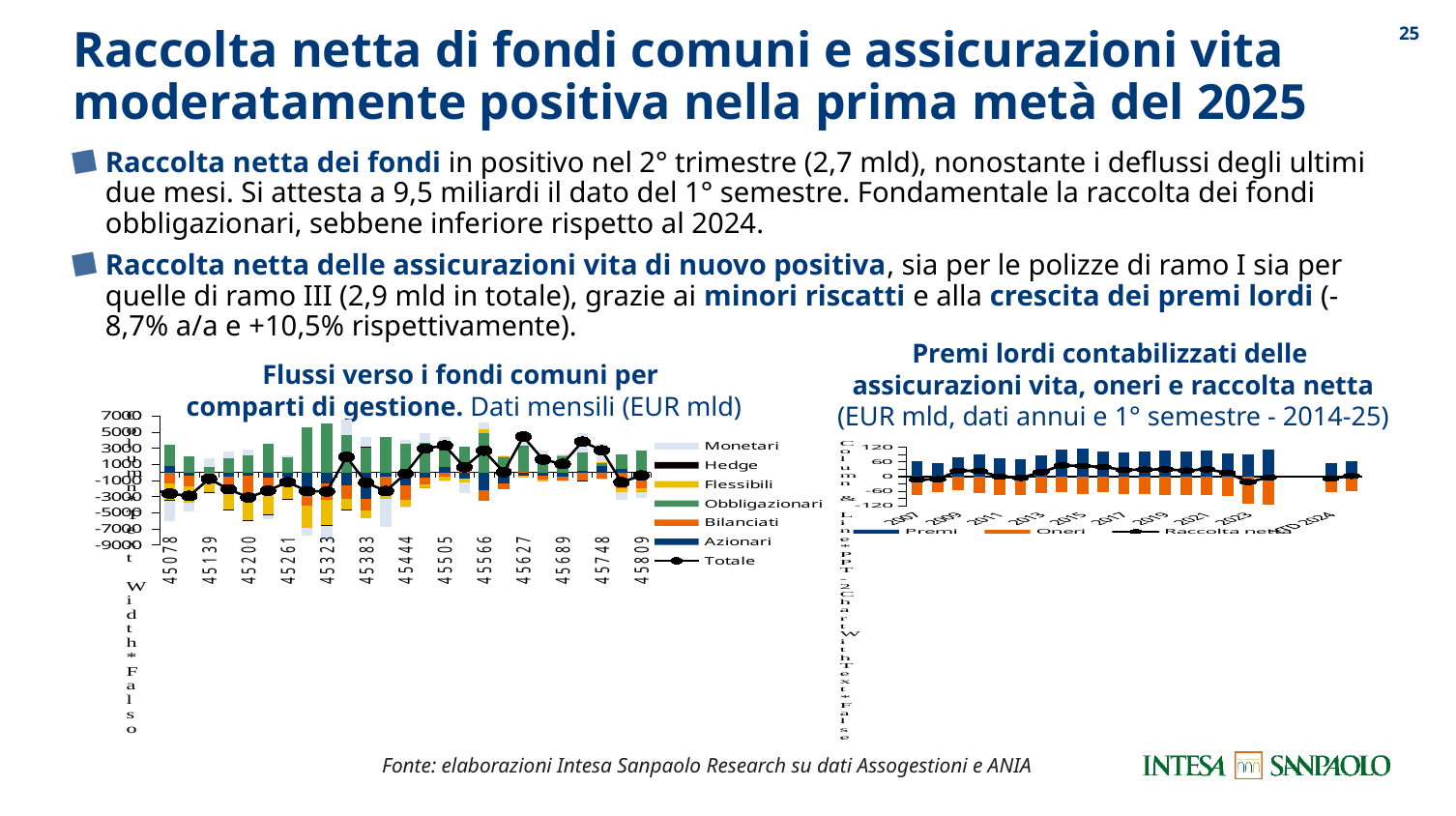
In the right chart 'Premi lordi contabilizzati delle assicurazioni vita, oneri e raccolta netta', are the Premi bars plotted above or below zero? Above zero How many series does the legend of the right chart 'Premi lordi contabilizzati delle assicurazioni vita, oneri e raccolta netta' list? 3 What unit is stated for the data in the right chart 'Premi lordi contabilizzati delle assicurazioni vita, oneri e raccolta netta'? EUR mld What is the first year label on the x axis of the right chart 'Premi lordi contabilizzati delle assicurazioni vita, oneri e raccolta netta'? 2007 In the right chart 'Premi lordi contabilizzati delle assicurazioni vita, oneri e raccolta netta', which series is shown as a line rather than bars? Raccolta netta What kind of chart is the right chart titled 'Premi lordi contabilizzati delle assicurazioni vita, oneri e raccolta netta'? Bar chart with a line In the left chart 'Flussi verso i fondi comuni per comparti di gestione', which series is plotted as a line with markers? Totale In the right chart 'Premi lordi contabilizzati delle assicurazioni vita, oneri e raccolta netta', are the Oneri bars plotted above or below zero? Below zero How many series does the legend of the left chart 'Flussi verso i fondi comuni per comparti di gestione' list? 7 What kind of chart is the left chart titled 'Flussi verso i fondi comuni per comparti di gestione'? Stacked bar chart with a line